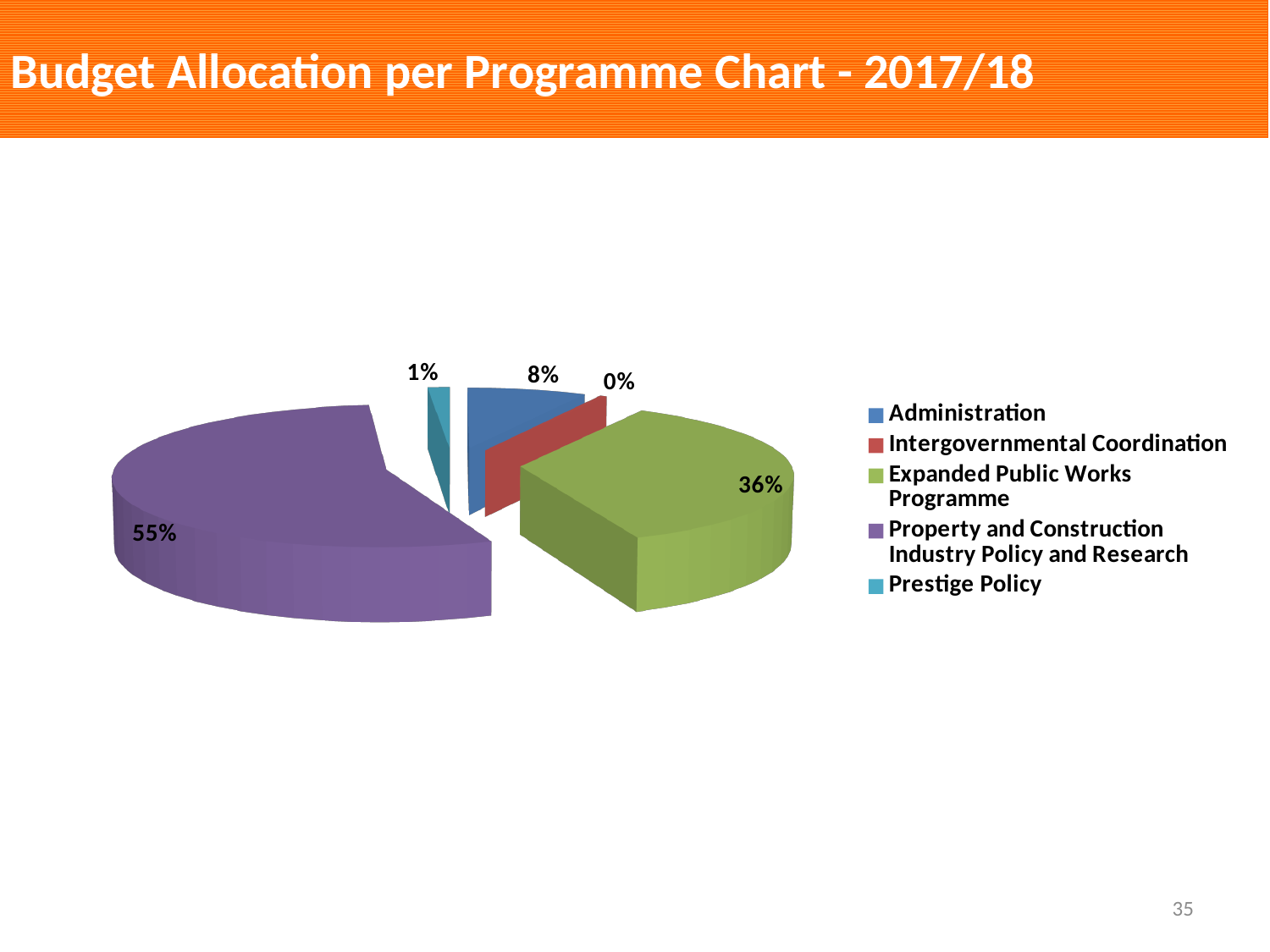
Which receives a larger share of the budget, Administration or Prestige Policy? Administration What share of the budget is allocated to Intergovernmental Coordination? 0% How many programmes are shown in the pie chart? 5 What share of the budget is allocated to Property and Construction Industry Policy and Research? 55% What share of the budget is allocated to Administration? 8% Which programme receives the smallest share of the budget? Intergovernmental Coordination What is the difference in percentage points between the shares for Property and Construction Industry Policy and Research and the Expanded Public Works Programme? 19 percentage points What kind of chart is shown on the slide? Pie chart What is the title of the slide containing the chart? Budget Allocation per Programme Chart - 2017/18 Which programme receives the largest share of the budget? Property and Construction Industry Policy and Research